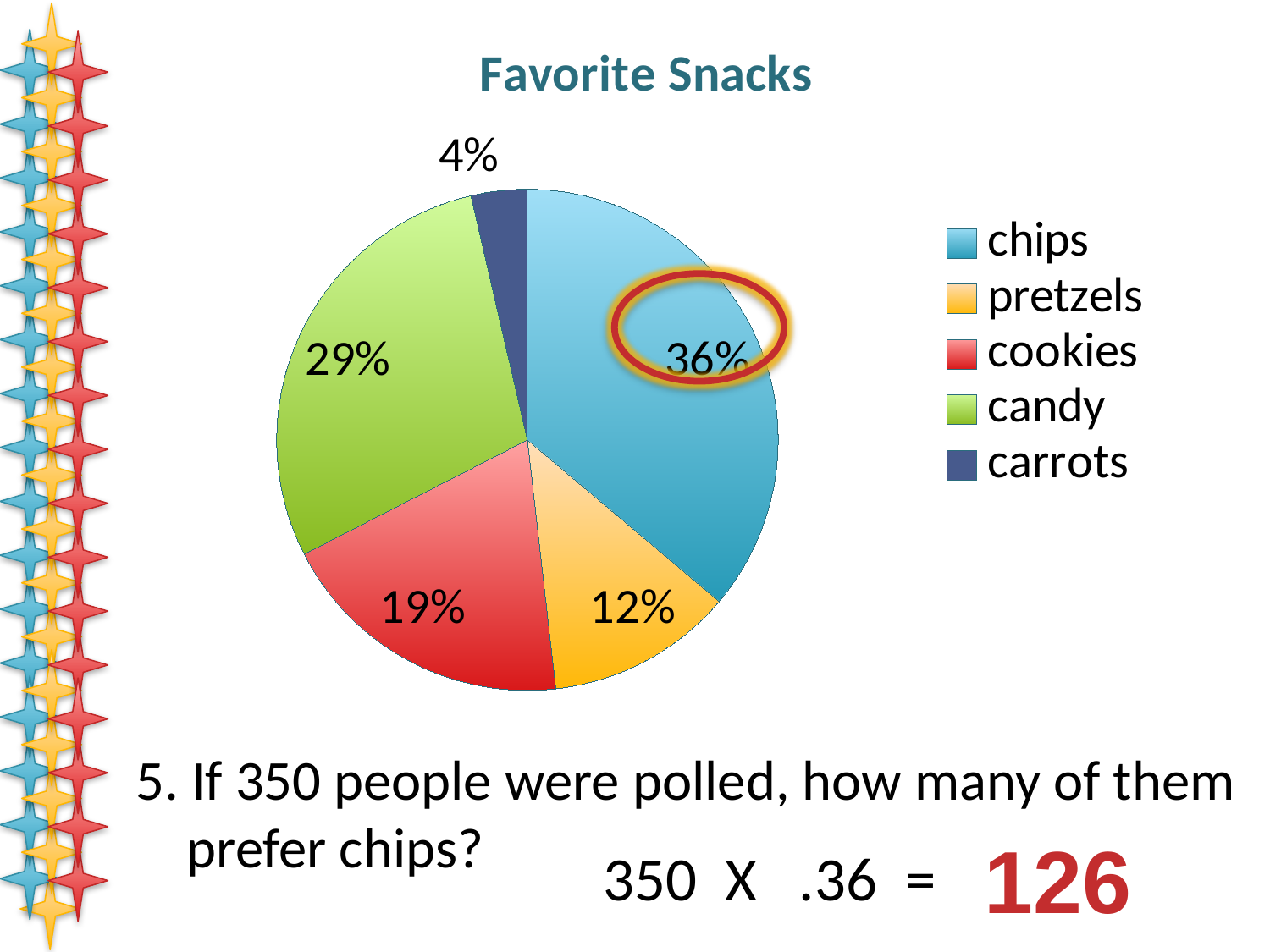
How many snack categories are shown in the Favorite Snacks pie chart? 5 What is the title of the chart? Favorite Snacks What percentage of the Favorite Snacks pie chart is candy? 29% Which slice is larger, cookies or pretzels? cookies Which snack has the largest share of the Favorite Snacks pie chart? chips What type of chart is shown on the slide? pie chart What is the difference in percentage points between the chips slice and the candy slice? 7 What percentage of the Favorite Snacks pie chart is cookies? 19% What percentage of the Favorite Snacks pie chart is chips? 36% What percentage of the Favorite Snacks pie chart is carrots? 4% What percentage of the Favorite Snacks pie chart is pretzels? 12% Which snack has the smallest share of the Favorite Snacks pie chart? carrots